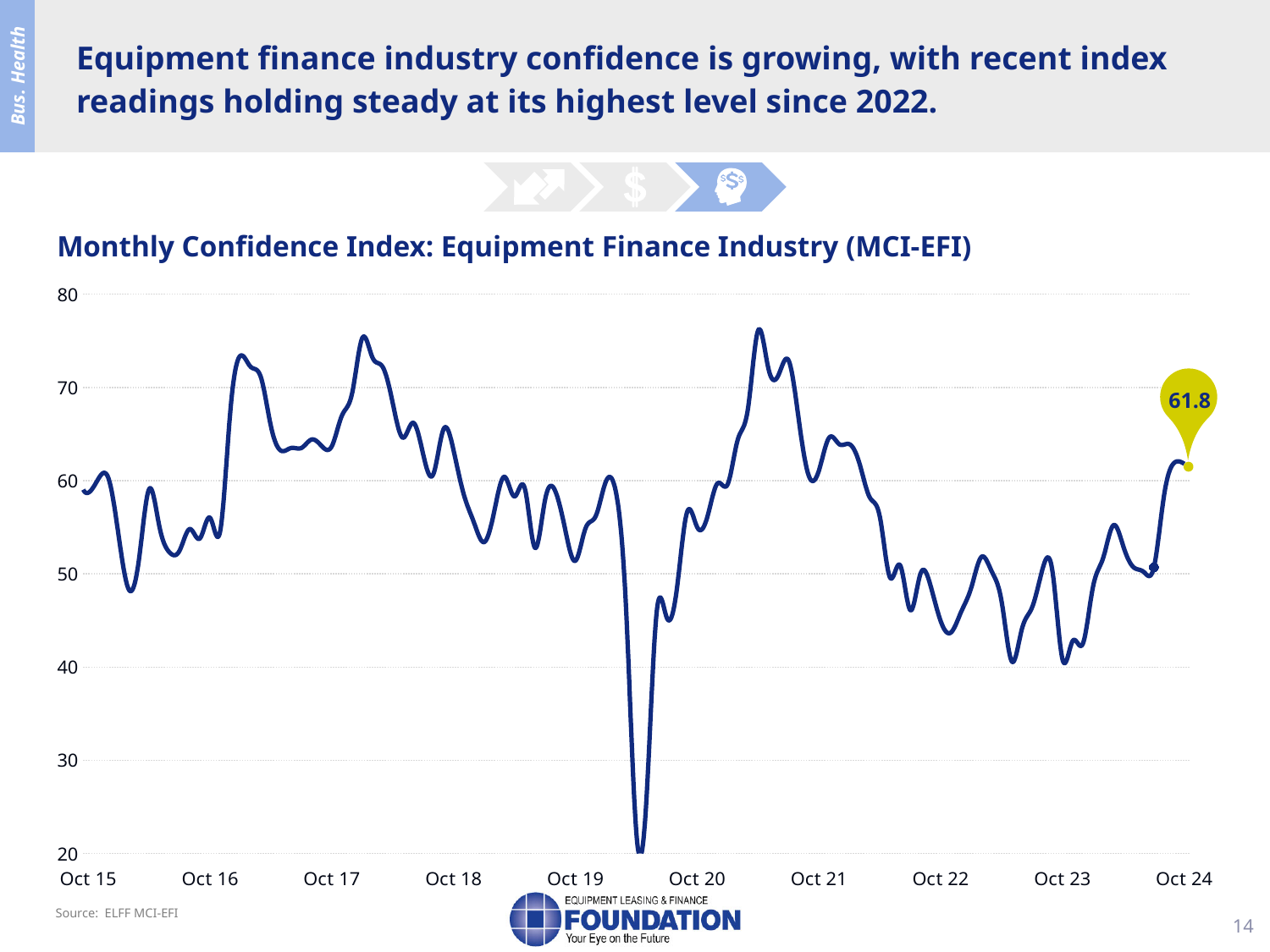
Is the value of the index at Oct 16 greater or less than 50? greater Which is larger, the index value at Oct 24 or the index value at Oct 23? Oct 24 What is the value of the Monthly Confidence Index at Oct 24, as labelled on the chart? 61.8 What kind of chart is used to show the Monthly Confidence Index? line chart Is the value of the index at Oct 19 greater or less than 60? less Is the value of the index at Oct 17 greater or less than 60? greater What is the title of the chart? Monthly Confidence Index: Equipment Finance Industry (MCI-EFI) How many date labels are shown on the x axis of the chart? 10 What source is cited for the chart? ELFF MCI-EFI